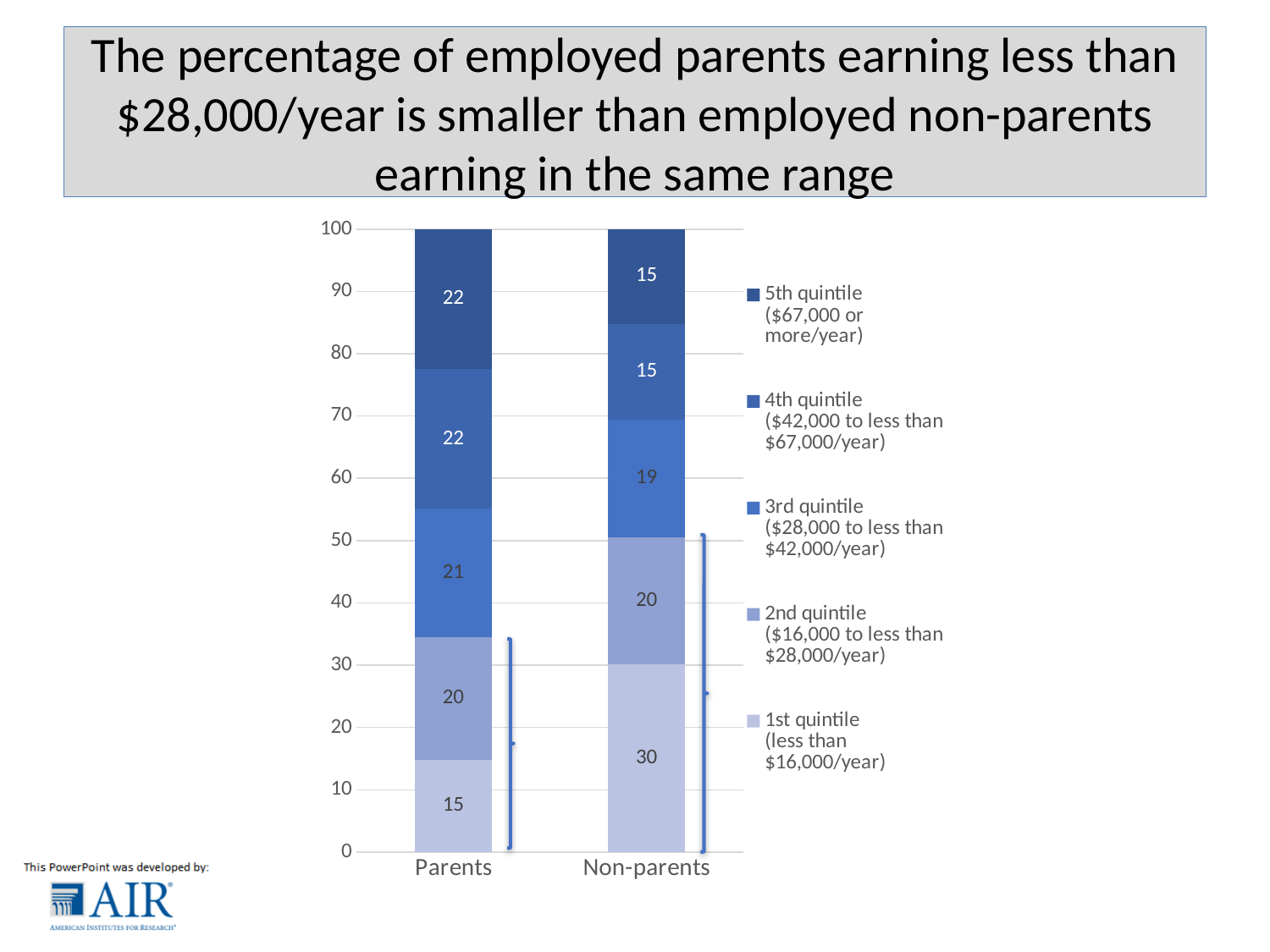
What is the combined value of the 1st and 2nd quintiles for Non-parents? 50 Which category has the larger value for the 1st quintile (less than $16,000/year), Parents or Non-parents? Non-parents What is the value for the 5th quintile ($67,000 or more/year) for Parents? 22 What is the value for the 1st quintile (less than $16,000/year) for Parents? 15 How many categories are shown on the x axis? 2 What kind of chart is shown on the slide? Stacked bar chart What is the value for the 3rd quintile ($28,000 to less than $42,000/year) for Non-parents? 19 What is the total of the stacked bar for Parents? 100 How many series does the legend list? 5 Which category has the larger value for the 5th quintile ($67,000 or more/year), Parents or Non-parents? Parents What is the value for the 1st quintile (less than $16,000/year) for Non-parents? 30 What is the difference between the 1st quintile values for Non-parents and Parents? 15